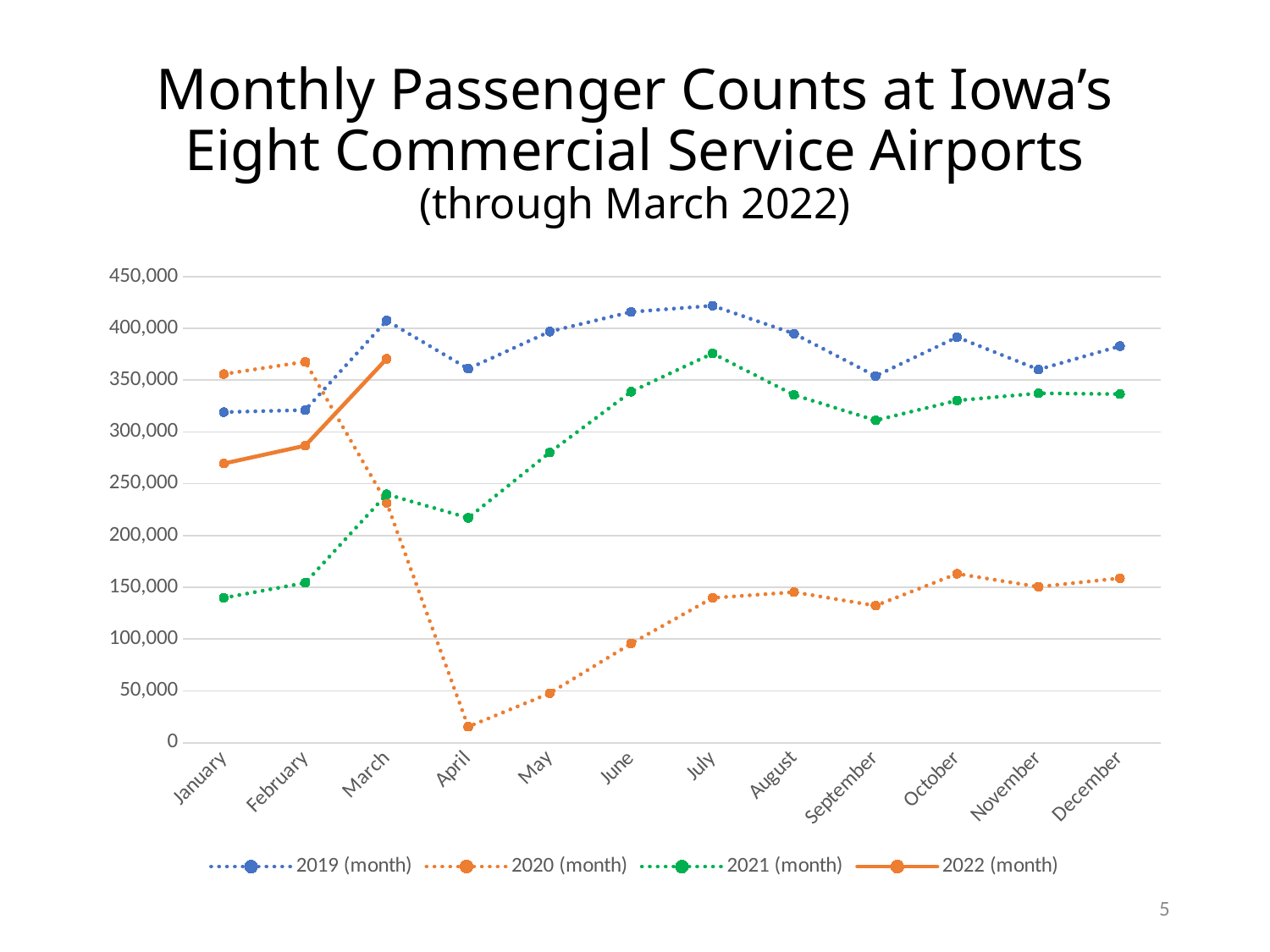
How many months are shown along the x axis? 12 Is the value for December in the 2020 (month) series greater or less than 200,000? less In January, which series has the higher value: 2019 (month) or 2020 (month)? 2020 (month) Is the value for April in the 2020 (month) series greater or less than 50,000? less Does the 2022 (month) series rise or fall from January to March? Rise In which month does the 2020 (month) series reach its lowest value? April How many series does the legend list? 4 What kind of chart is shown on the slide? Line chart In which month does the 2021 (month) series have its lowest value? January Is the value for March in the 2022 (month) series greater or less than 350,000? greater In which month does the 2021 (month) series reach its highest value? July In April, which series has the higher value: 2020 (month) or 2021 (month)? 2021 (month)